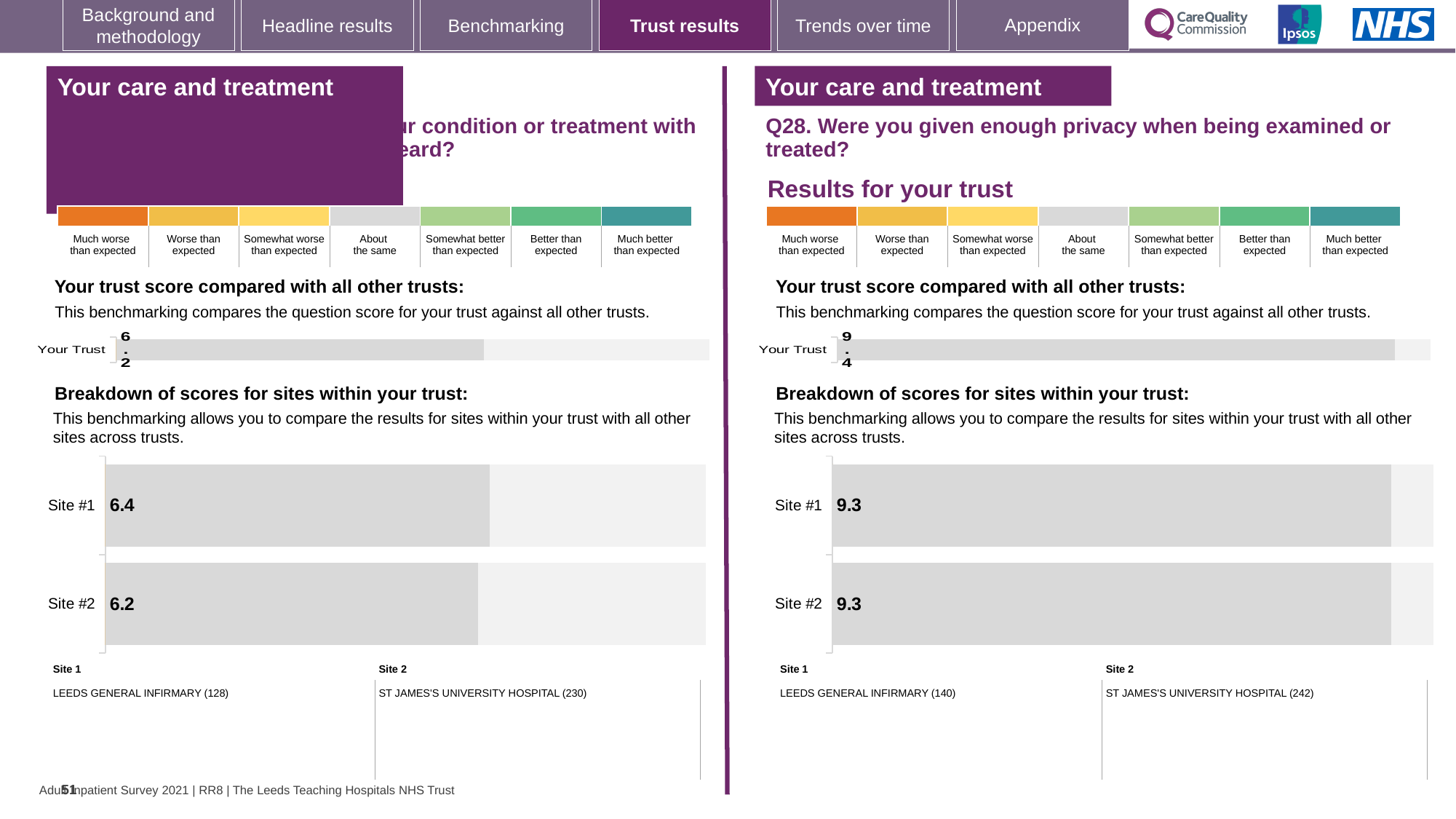
On the right half of the slide (Q28), which hospital is listed as Site 2? ST JAMES'S UNIVERSITY HOSPITAL (242) On the right half of the slide (Q28), what is the score shown for Site #1? 9.3 What kind of chart is used for the breakdown of scores for sites within your trust on the left half of the slide? Bar chart On the left half of the slide, what is the score shown for Site #2 in the breakdown of scores for sites within your trust? 6.2 On the left half of the slide, what is the 'Your Trust' score in the trust score comparison chart? 6.2 On the left half of the slide, which site has the higher score in the breakdown of scores for sites within your trust? Site #1 On the left half of the slide, what is the score shown for Site #1 in the breakdown of scores for sites within your trust? 6.4 On the right half of the slide (Q28), what is the difference between the 'Your Trust' score and the Site #1 score? 0.1 How many sites are shown in the breakdown of scores chart on the right half of the slide (Q28)? 2 On the right half of the slide (Q28, privacy when being examined or treated), what is the 'Your Trust' score? 9.4 On the right half of the slide (Q28), what is the score shown for Site #2? 9.3 On the left half of the slide, what is the difference between the Site #1 and Site #2 scores? 0.2